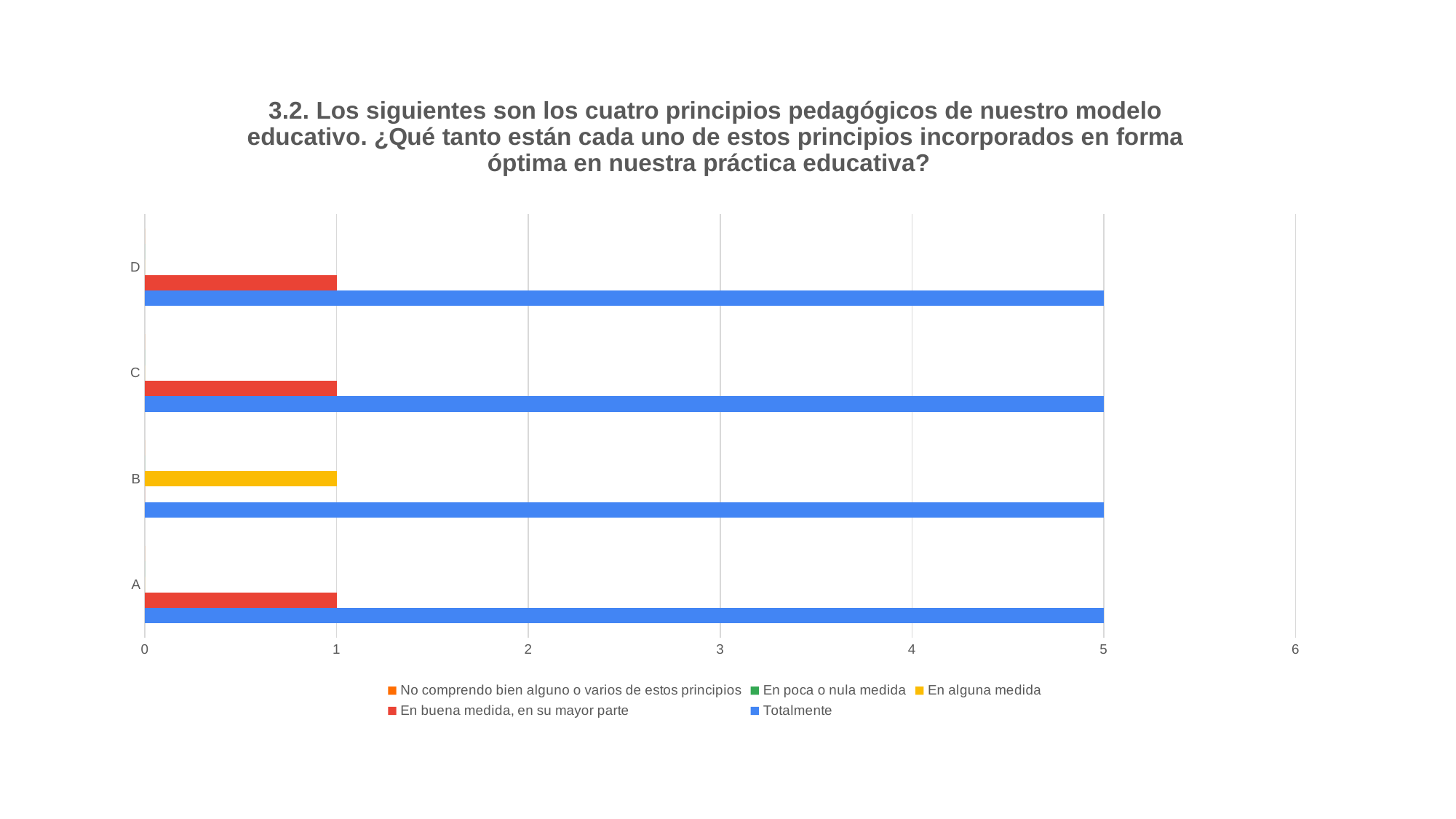
For category C, which is larger: the "Totalmente" value or the "En buena medida, en su mayor parte" value? Totalmente What is the value of the "Totalmente" series for category C? 5 What is the value of the "Totalmente" series for category A? 5 How many series does the legend list? 5 What kind of chart is shown on the slide? bar chart What is the difference between the "Totalmente" value and the "En buena medida, en su mayor parte" value for category A? 4 How many categories are shown on the vertical axis of the chart? 4 What is the value of the "En alguna medida" series for category B? 1 Which series has the highest value for category B? Totalmente Which category is the only one with a bar for the "En alguna medida" series? B Is the "Totalmente" value for category D greater or less than 3? greater What is the value of the "En buena medida, en su mayor parte" series for category D? 1